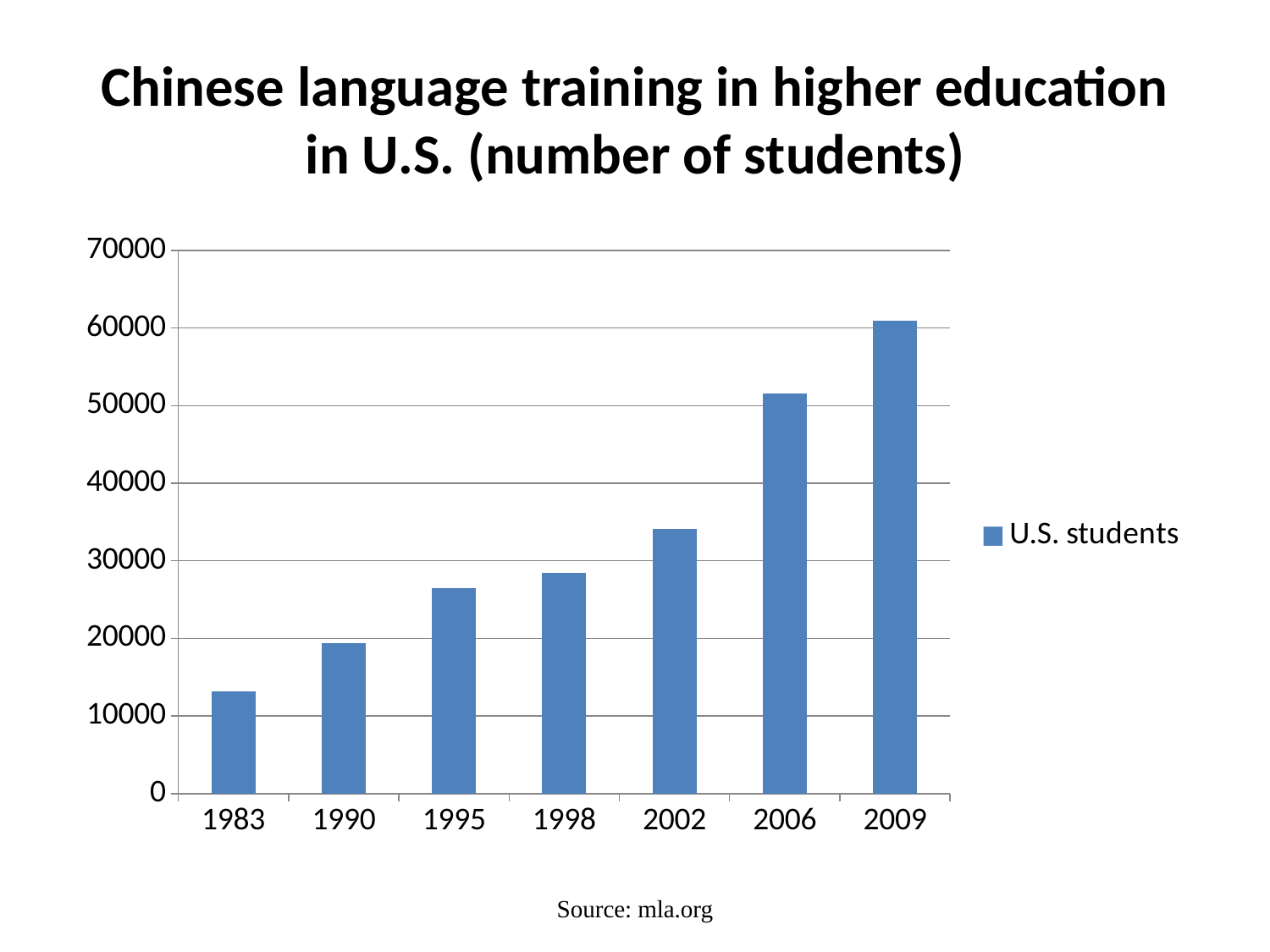
Which year has the larger value, 1998 or 2002? 2002 Is the value for 1995 greater or less than 30000? less What kind of chart is shown on the slide? bar chart Is the value for 2002 greater or less than 40000? less Is the value for 1983 greater or less than 10000? greater How many series does the legend list? 1 What is the name of the series shown in the legend? U.S. students How many years are shown on the x axis of the chart? 7 Do the values rise or fall from 1983 to 2009? rise Which year has the highest number of U.S. students? 2009 Which year has the lowest number of U.S. students? 1983